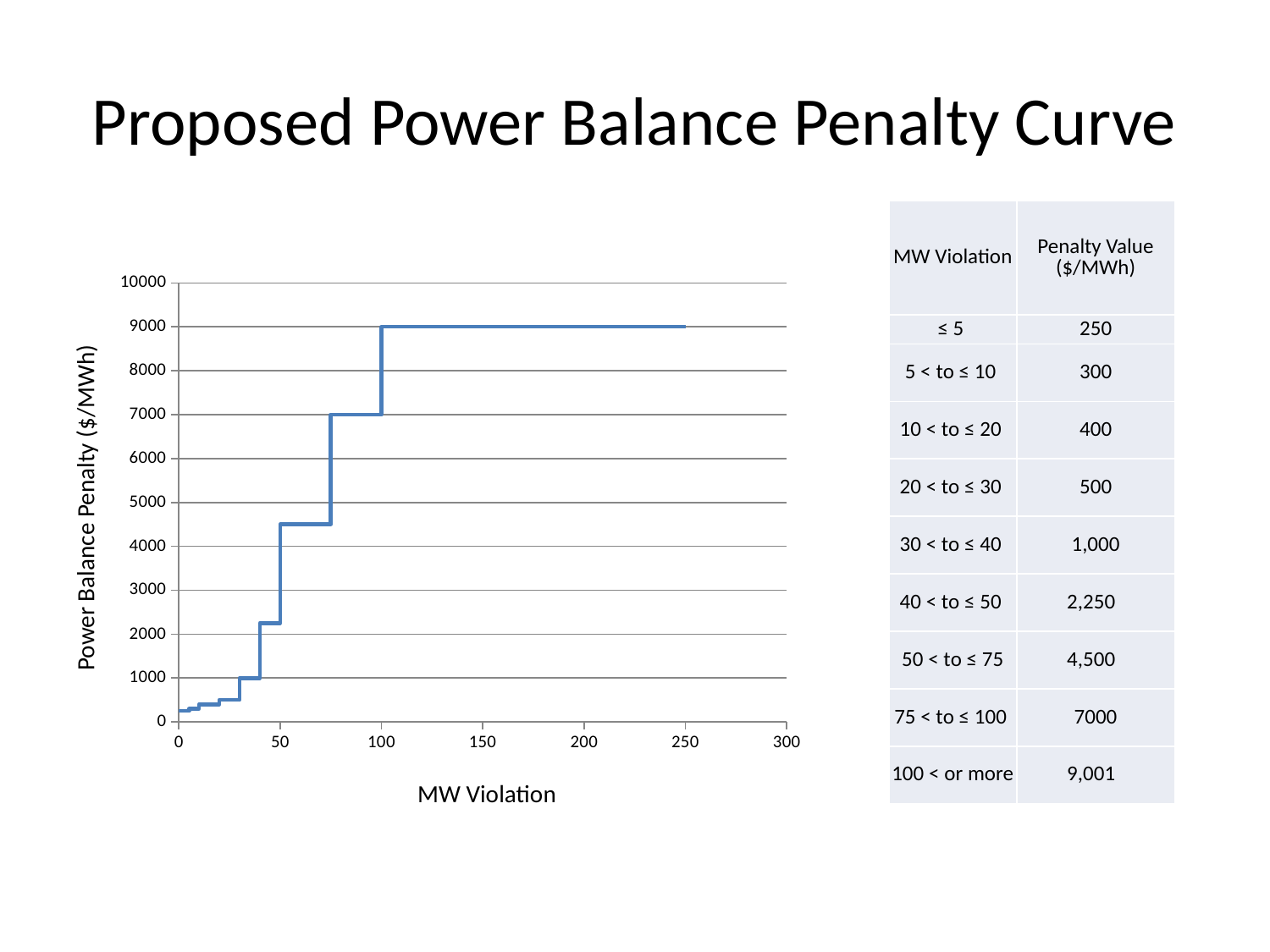
Is the Power Balance Penalty at an MW Violation of 35 greater or less than 2000? less Is the Power Balance Penalty at an MW Violation of 150 greater or less than 8000? greater What is the Power Balance Penalty ($/MWh) at an MW Violation of 80? 7000 Does the Power Balance Penalty rise or fall as MW Violation increases along the x axis? rise What is the title of the chart's x axis? MW Violation Which has the larger Power Balance Penalty: an MW Violation of 20 or an MW Violation of 60? 60 What kind of chart is shown on the slide? line chart At what MW Violation value does the plotted line end on the x axis? 250 Is the Power Balance Penalty at an MW Violation of 90 greater or less than 6000? greater What is the title of the chart's y axis? Power Balance Penalty ($/MWh)